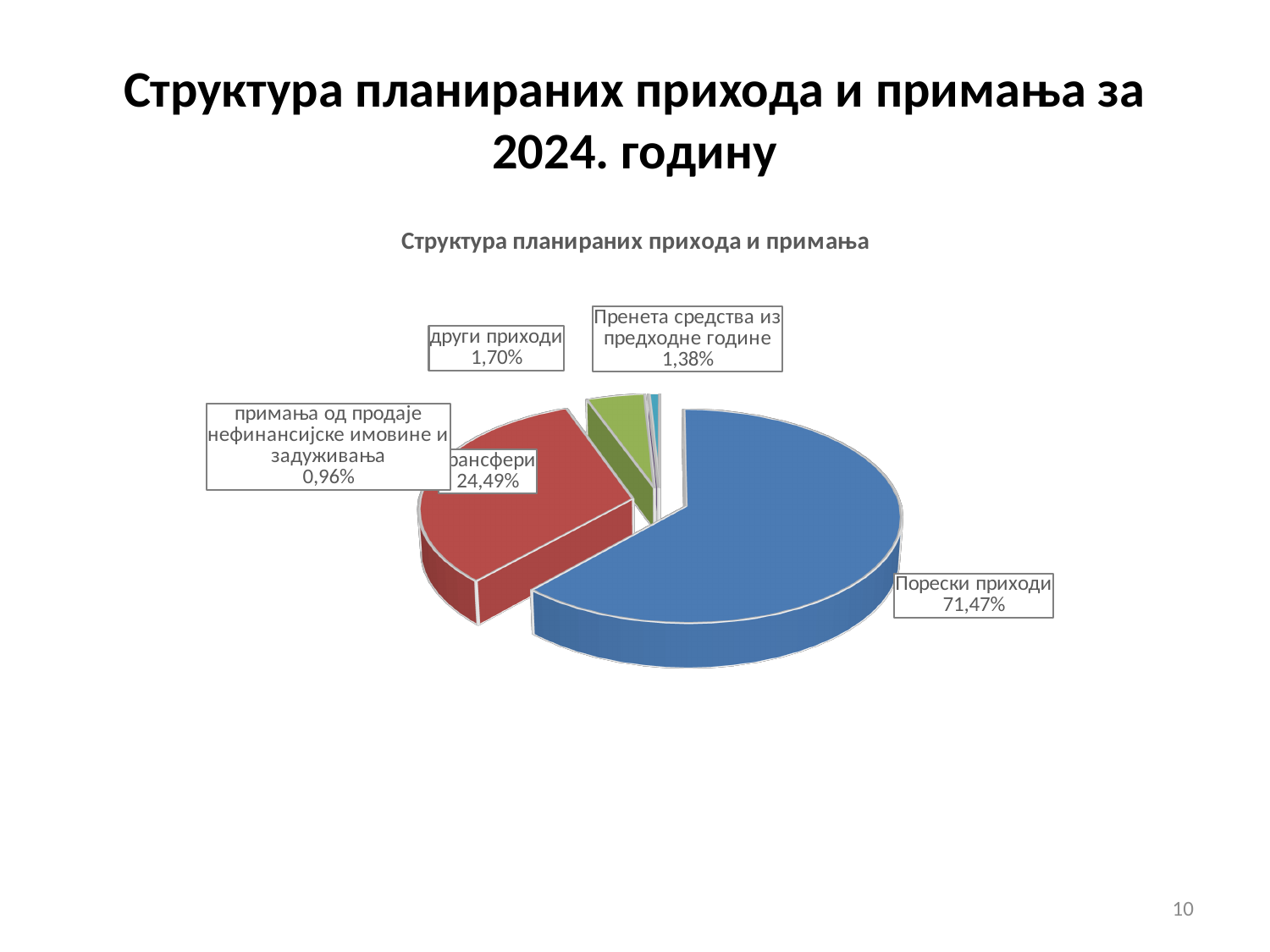
What kind of chart is shown on the slide? pie chart Which is larger, the share of други приходи or the share of Пренета средства из предходне године? други приходи What share of the pie is Порески приходи? 71,47% How many slices does the pie chart have? 5 Which category has the largest share of the pie? Порески приходи What is the title of the chart? Структура планираних прихода и примања What is the difference between the share of Порески приходи and the share of трансфери? 46,98% What is the value shown for примања од продаје нефинансијске имовине и задуживања? 0,96% What is the value shown for Пренета средства из предходне године? 1,38% What is the value shown for the red slice (трансфери)? 24,49% What is the value shown for други приходи? 1,70% Which category has the smallest share of the pie? примања од продаје нефинансијске имовине и задуживања